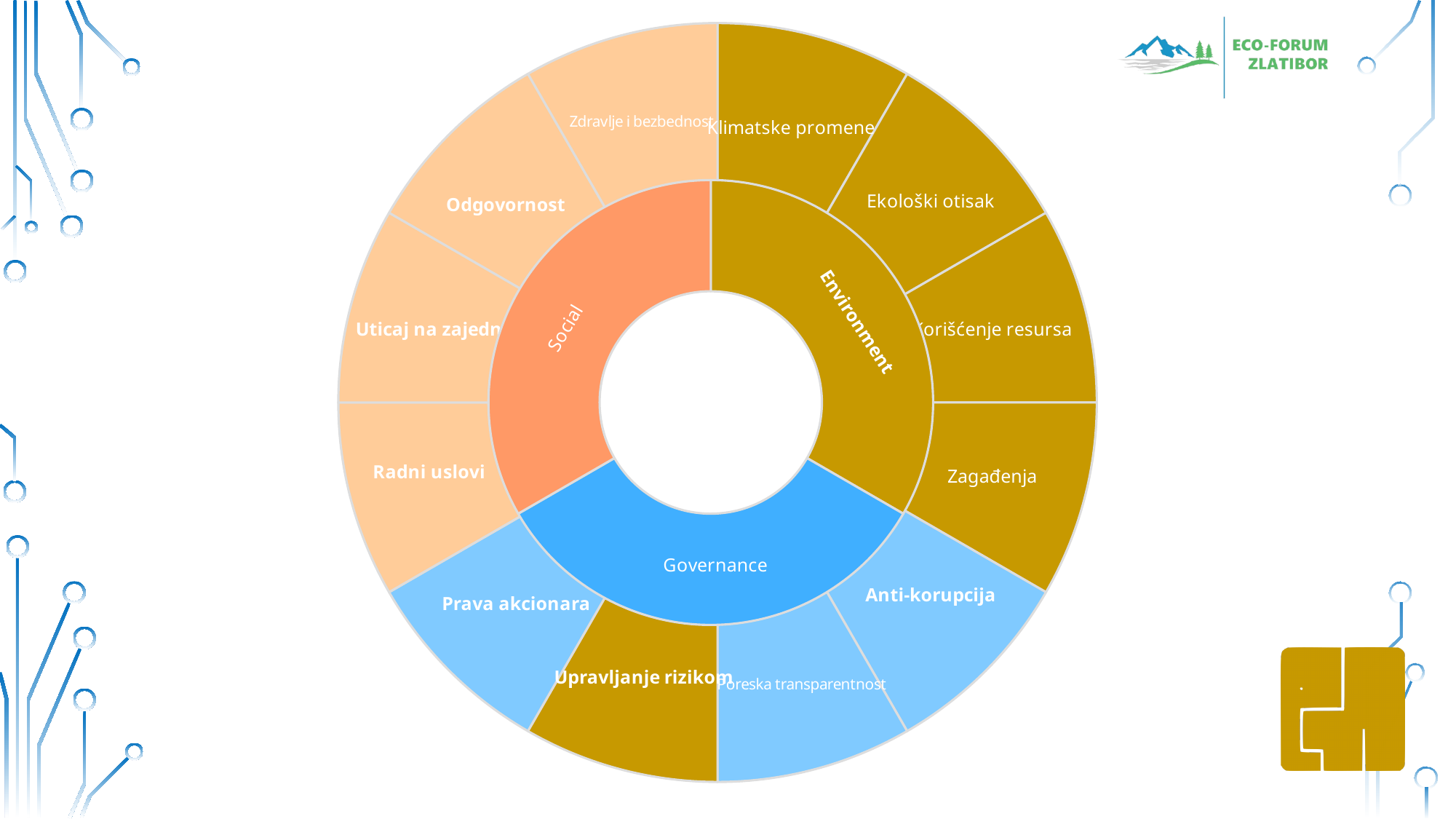
Which inner-ring category does the segment 'Zagađenja' belong to? Environment What colour is used for the Social category in the chart? Orange What colour is used for the Governance category in the chart? Blue How many sub-segments belong to the Governance category? 4 How many segments are in the outer ring of the chart? 12 Which inner-ring category does the segment 'Anti-korupcija' belong to? Governance Which inner-ring category does the segment 'Radni uslovi' belong to? Social Which inner-ring category does the segment 'Ekološki otisak' belong to? Environment How many sub-segments belong to the Environment category? 4 What kind of chart is shown on the slide? Doughnut chart Which inner-ring category does the segment 'Prava akcionara' belong to? Governance